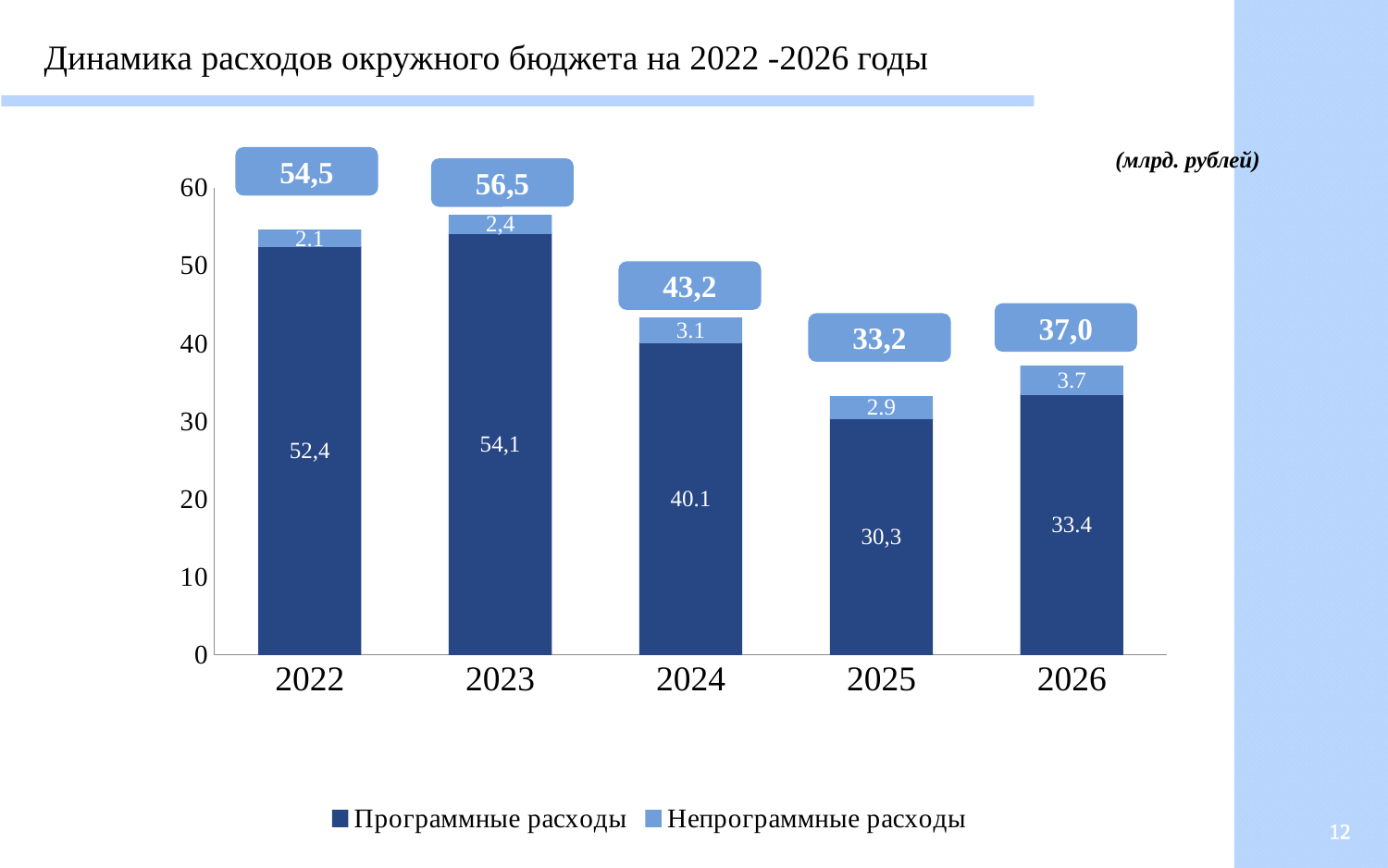
What is the total shown above the bar for 2024? 43,2 What type of chart is shown on the slide? Stacked bar chart What is the value of Программные расходы for 2023? 54,1 What is the value of Непрограммные расходы for 2026? 3.7 How many years are shown on the x axis? 5 How many series does the legend list? 2 Which year has the highest total expenditure? 2023 What unit is indicated for the values on the chart? млрд. рублей Which year has the lowest total expenditure? 2025 What is the difference between the totals for 2023 and 2022? 2,0 Which is larger: Программные расходы in 2024 or in 2026? 2024 Is the total for 2025 greater or less than 40? less